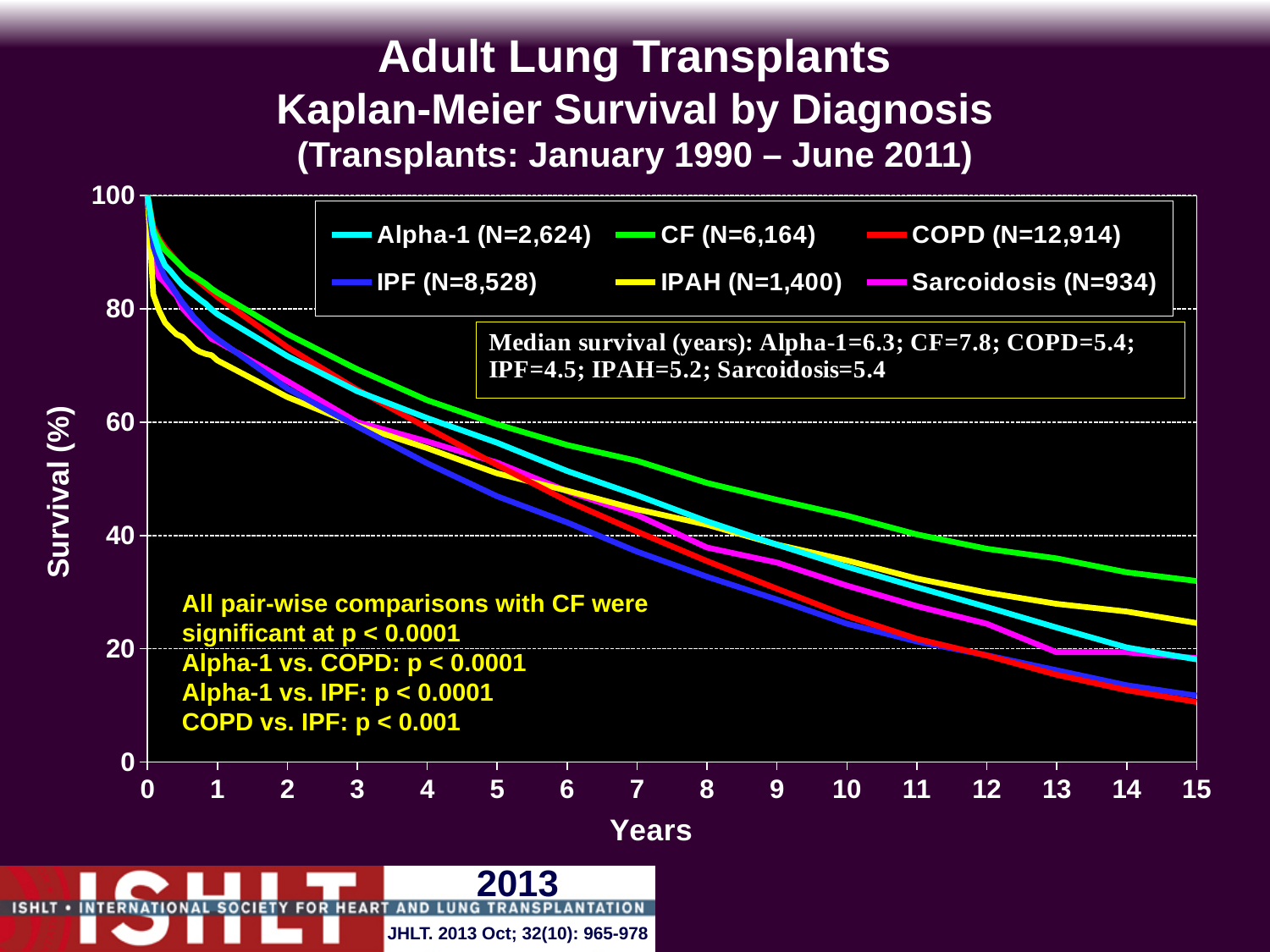
How many series does the legend list? 6 What is the difference in median survival between CF and IPF? 3.3 years What is the number of patients (N) for COPD shown in the legend? 12,914 Is the survival for IPF at 15 years greater or less than 20? less What is the median survival in years for CF? 7.8 What is the median survival in years for IPF? 4.5 Which diagnosis has the highest median survival? CF Is the survival for CF at 15 years greater or less than 20? greater What kind of chart is shown on the slide? line chart Which diagnosis has the smallest number of patients (N) in the legend? Sarcoidosis Do the survival curves rise or fall as years increase? fall Which diagnosis has the lowest median survival? IPF